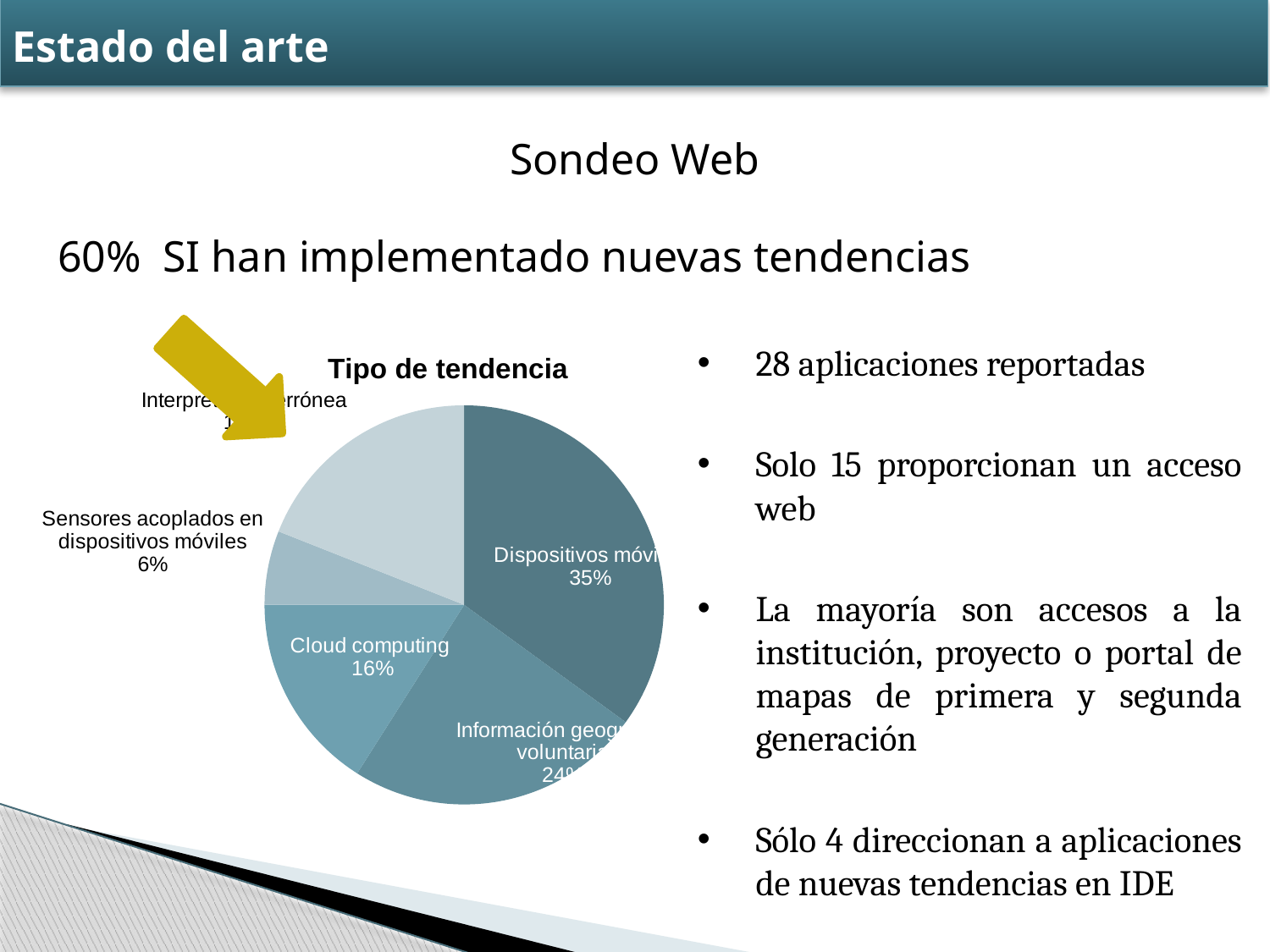
What share of the Tipo de tendencia pie does Dispositivos móviles account for? 35% Which category has the largest slice in the Tipo de tendencia pie chart? Dispositivos móviles What is the title of the pie chart? Tipo de tendencia How many slices does the Tipo de tendencia pie chart have? 5 By how many percentage points does Dispositivos móviles exceed Cloud computing in the Tipo de tendencia pie chart? 19 percentage points Which category has the smallest slice in the Tipo de tendencia pie chart? Sensores acoplados en dispositivos móviles Which slice is larger in the Tipo de tendencia pie chart: Cloud computing or Sensores acoplados en dispositivos móviles? Cloud computing What percentage does the Sensores acoplados en dispositivos móviles slice represent in the Tipo de tendencia pie chart? 6% What percentage does the Cloud computing slice represent in the Tipo de tendencia pie chart? 16% What kind of chart is shown on the slide? Pie chart What percentage does the Dispositivos móviles slice represent in the Tipo de tendencia pie chart? 35% By how many percentage points does Cloud computing exceed Sensores acoplados en dispositivos móviles in the Tipo de tendencia pie chart? 10 percentage points